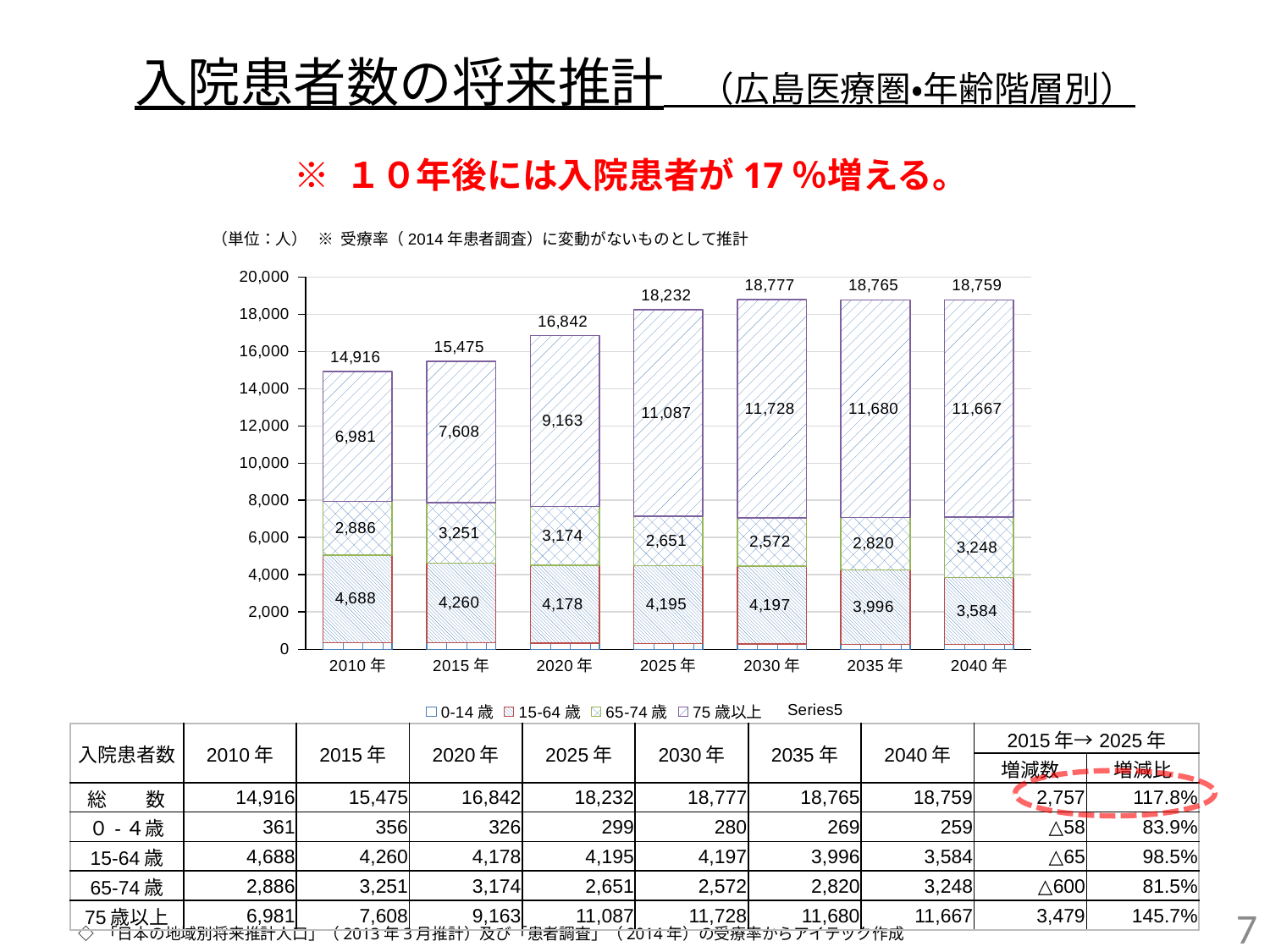
How many entries does the chart legend list? 5 What kind of chart is shown on the slide? stacked bar chart Is the total for 2015年 greater or less than 16,000? less Which year has the highest total number of hospitalized patients? 2030年 How many years are shown on the x axis of the chart? 7 What is the difference between the 75歳以上 values for 2010年 and 2040年? 4,686 What is the total number of hospitalized patients shown for 2025年? 18,232 What is the value of the 65-74歳 segment for 2030年? 2,572 Which year has the lowest total number of hospitalized patients? 2010年 Which is larger, the 15-64歳 segment in 2010年 or the 15-64歳 segment in 2035年? 2010年 What is the value of the 15-64歳 segment for 2040年? 3,584 What is the value of the 75歳以上 segment for 2020年? 9,163